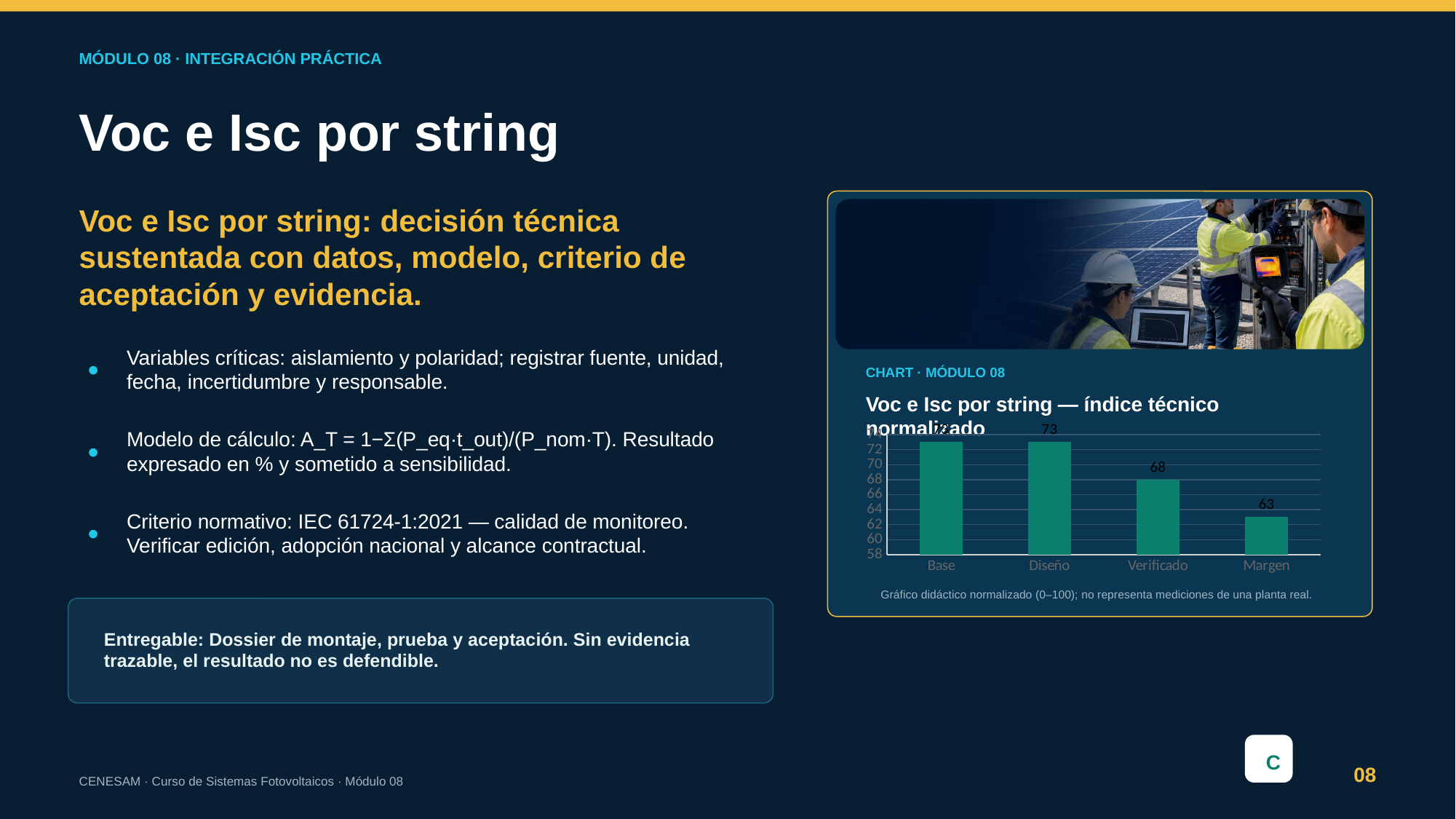
What is the difference between the values for Diseño and Verificado? 5 What is the value for Diseño in the chart? 73 Which is larger, the value for Verificado or the value for Margen? Verificado What is the difference between the values for Verificado and Margen? 5 Is the value for Base greater or less than 70? greater What is the title of the chart? Voc e Isc por string — índice técnico normalizado What kind of chart is shown on the slide? bar chart What is the value for Verificado in the chart? 68 What is the value for Margen in the chart? 63 How many categories are shown on the x axis of the chart? 4 What is the difference between the values for Diseño and Margen? 10 Which category has the lowest value in the chart? Margen